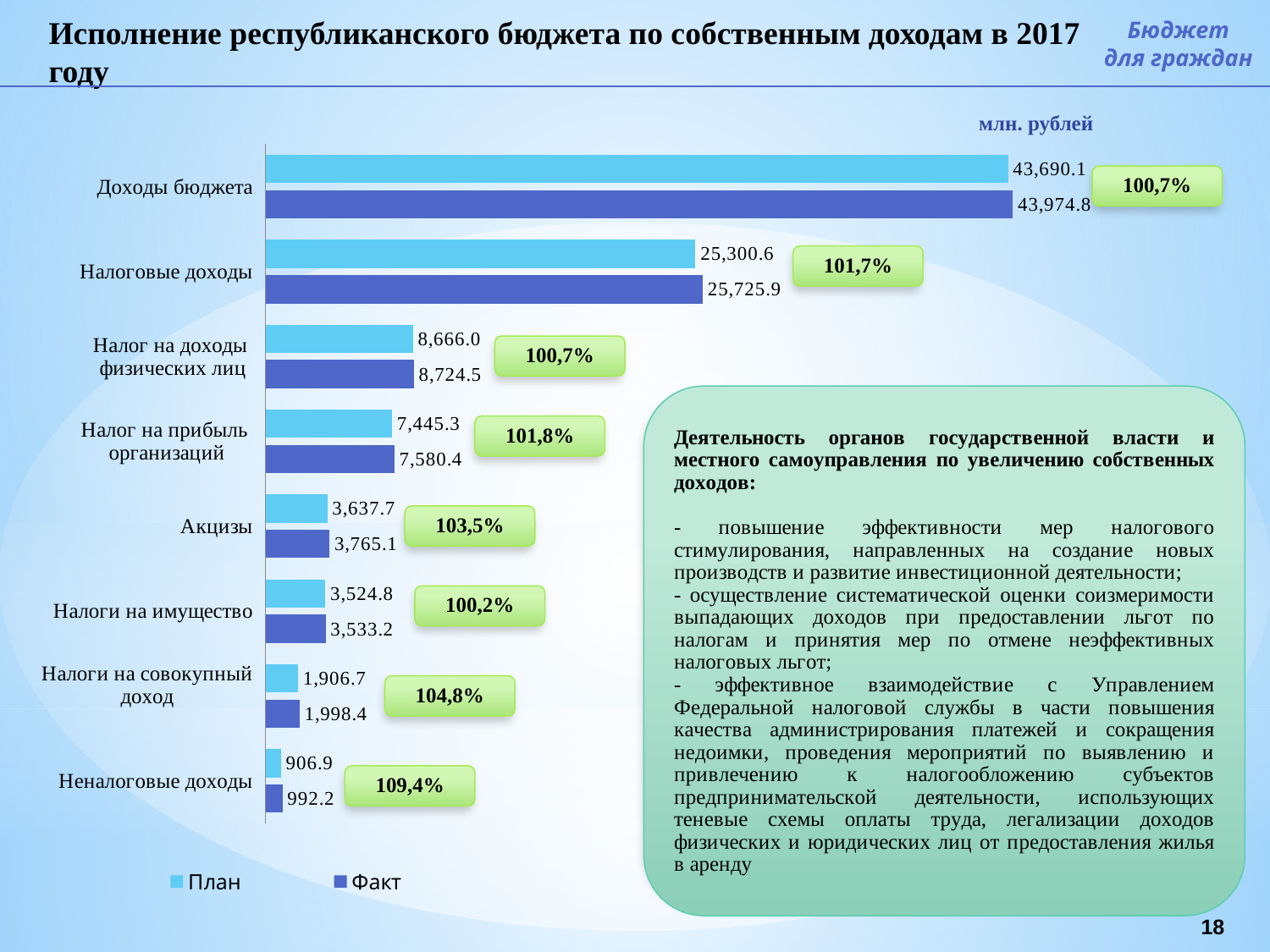
What is the Факт value for Акцизы? 3,765.1 What is the Факт value for Неналоговые доходы? 992.2 What is the difference between the Факт and План values for Акцизы? 127.4 What is the План value for Налоговые доходы? 25,300.6 How many categories are shown on the chart? 8 Which is larger for Налоги на совокупный доход, the План value or the Факт value? Факт How many series does the legend list? 2 What kind of chart is shown on the slide? Bar chart What is the План value for Налог на прибыль организаций? 7,445.3 Which category has the highest Факт value? Доходы бюджета What is the difference between the Факт and План values for Доходы бюджета? 284.7 Which category has the lowest План value? Неналоговые доходы